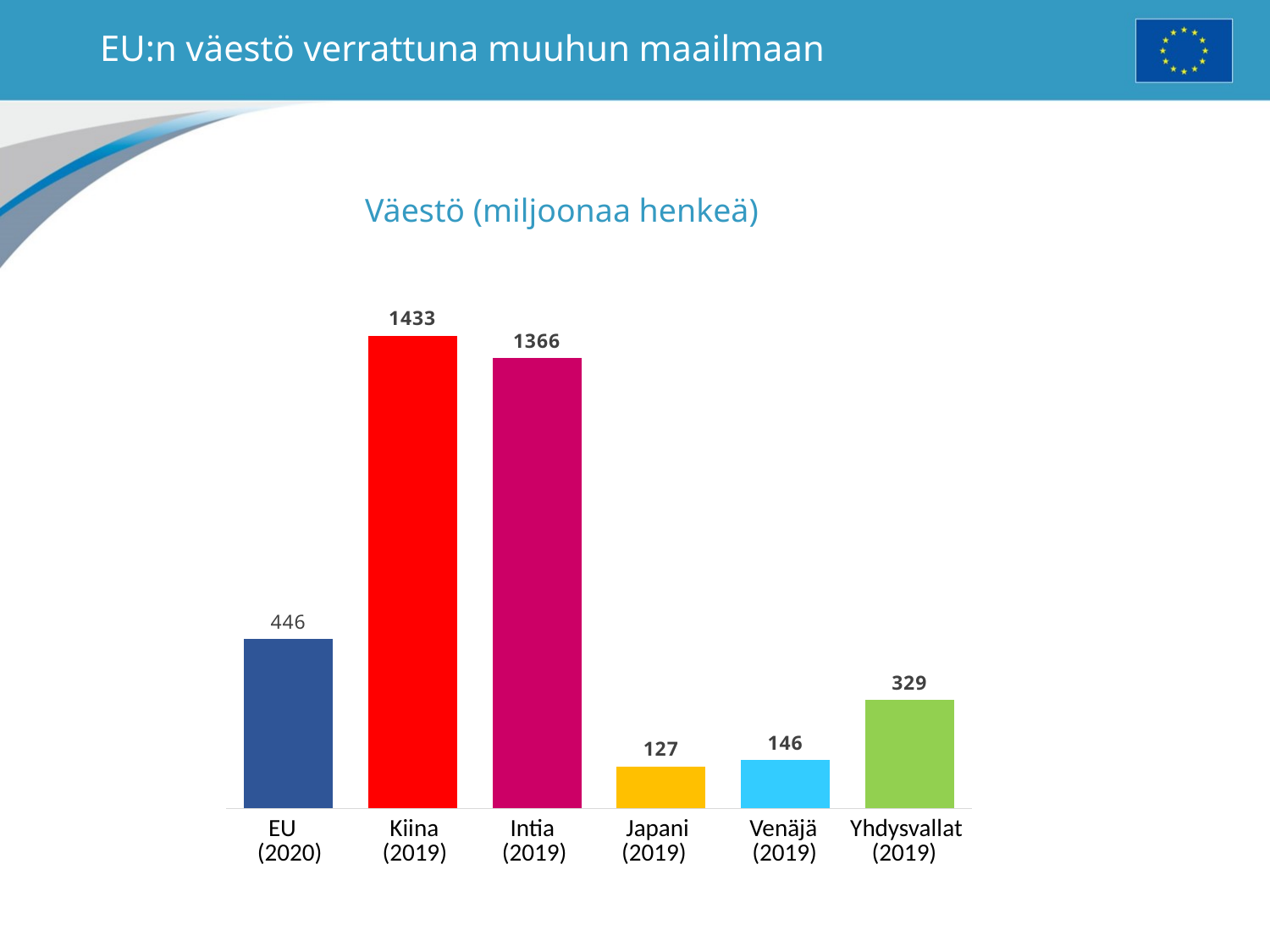
What is the difference between the values for Kiina (2019) and Intia (2019)? 67 What is the difference between the values for EU (2020) and Yhdysvallat (2019)? 117 What is the population value shown for Kiina (2019)? 1433 What is the title of the chart? Väestö (miljoonaa henkeä) Which is larger, the value for Venäjä (2019) or the value for Japani (2019)? Venäjä (2019) What colour is the bar for Kiina (2019)? Red How many categories are shown in the chart? 6 What kind of chart is shown on the slide? Bar chart Which category has the lowest value in the chart? Japani (2019) What is the population value shown for EU (2020)? 446 Which category has the highest value in the chart? Kiina (2019) What is the population value shown for Yhdysvallat (2019)? 329